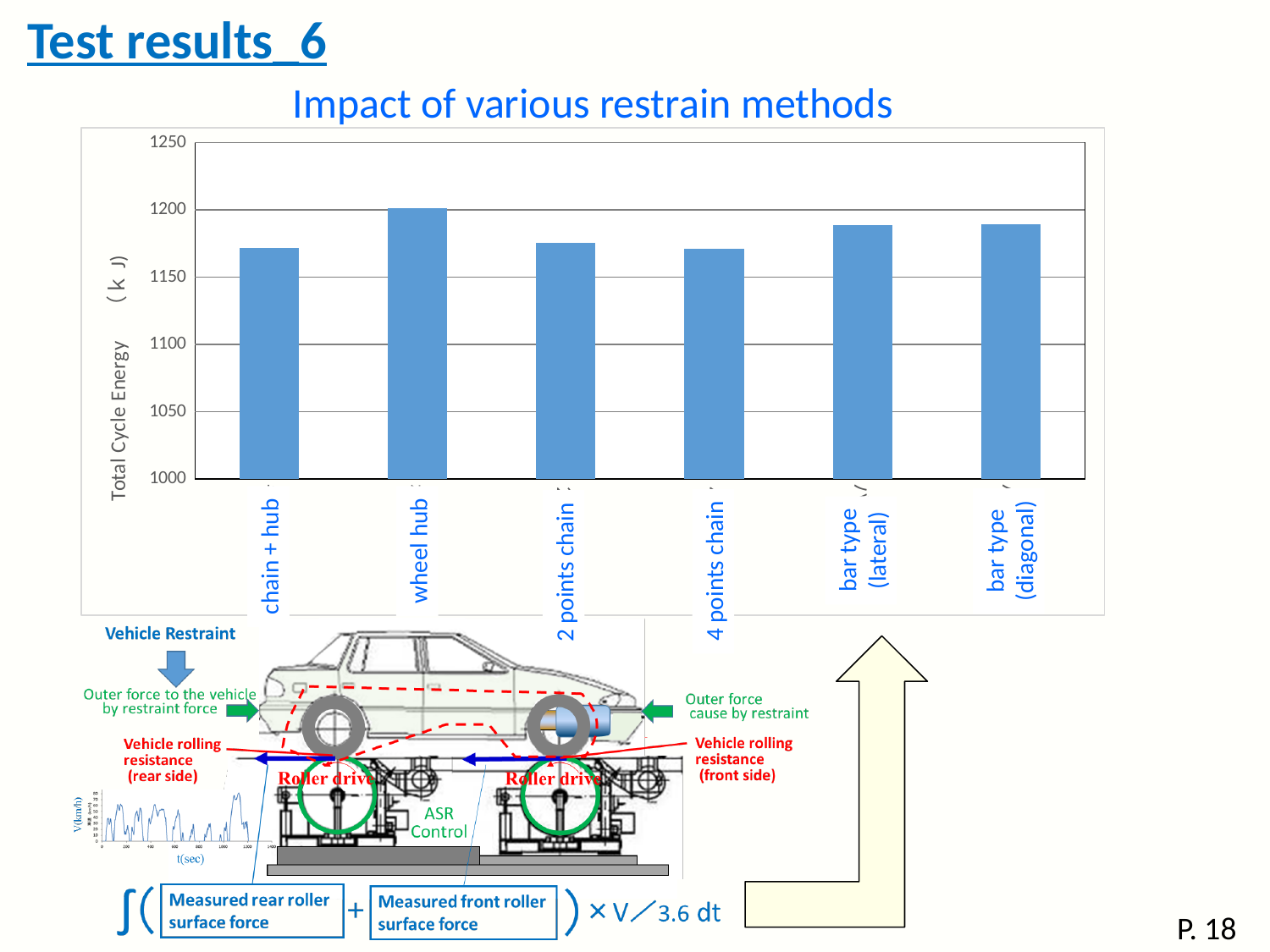
What is the title shown above the chart? Impact of various restrain methods Which restraint method has the highest Total Cycle Energy? wheel hub Is the Total Cycle Energy for chain + hub greater or less than 1200? less Which has a higher Total Cycle Energy, wheel hub or 4 points chain? wheel hub Which has a higher Total Cycle Energy, 2 points chain or bar type (lateral)? bar type (lateral) Is the Total Cycle Energy for 4 points chain greater or less than 1100? greater What kind of chart is shown on the slide? bar chart Which has a higher Total Cycle Energy, wheel hub or chain + hub? wheel hub How many restraint methods (categories) are plotted in the chart? 6 What is the label of the vertical axis of the chart? Total Cycle Energy (kJ) Is the Total Cycle Energy for bar type (lateral) greater or less than 1150? greater